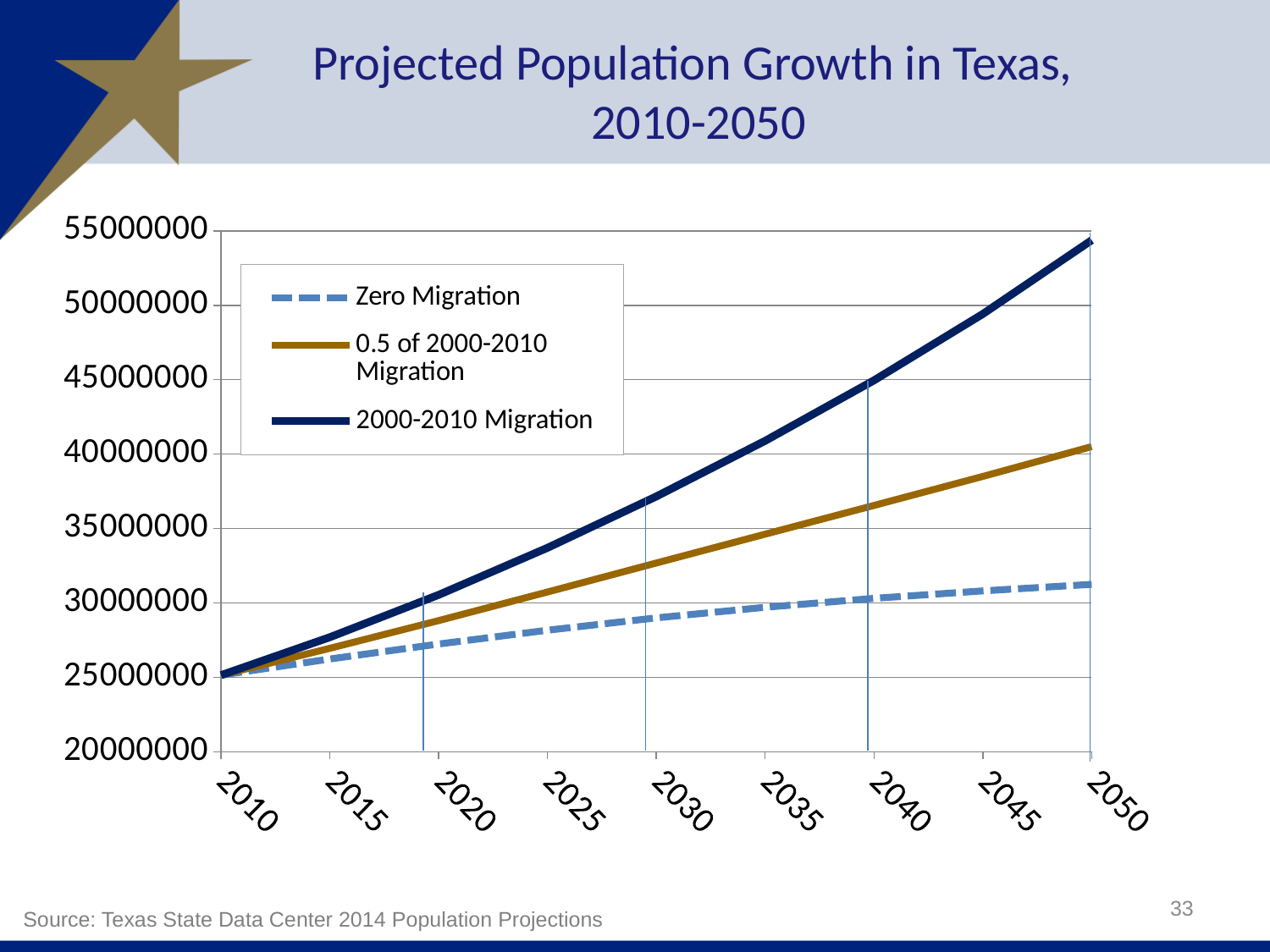
Which series has the highest value in 2050? 2000-2010 Migration Is the value for Zero Migration in 2050 greater or less than 30000000? greater Is the value for Zero Migration in 2030 greater or less than 30000000? less How many series does the legend list? 3 In 2040, which is larger: the value for 2000-2010 Migration or the value for Zero Migration? 2000-2010 Migration What kind of chart is shown on the slide? line chart How many years are labelled along the x axis? 9 Is the value for 0.5 of 2000-2010 Migration in 2050 greater or less than 45000000? less Which series has the lowest value in 2050? Zero Migration Do the values for 2000-2010 Migration rise or fall from 2010 to 2050? rise What is the title of the chart? Projected Population Growth in Texas, 2010-2050